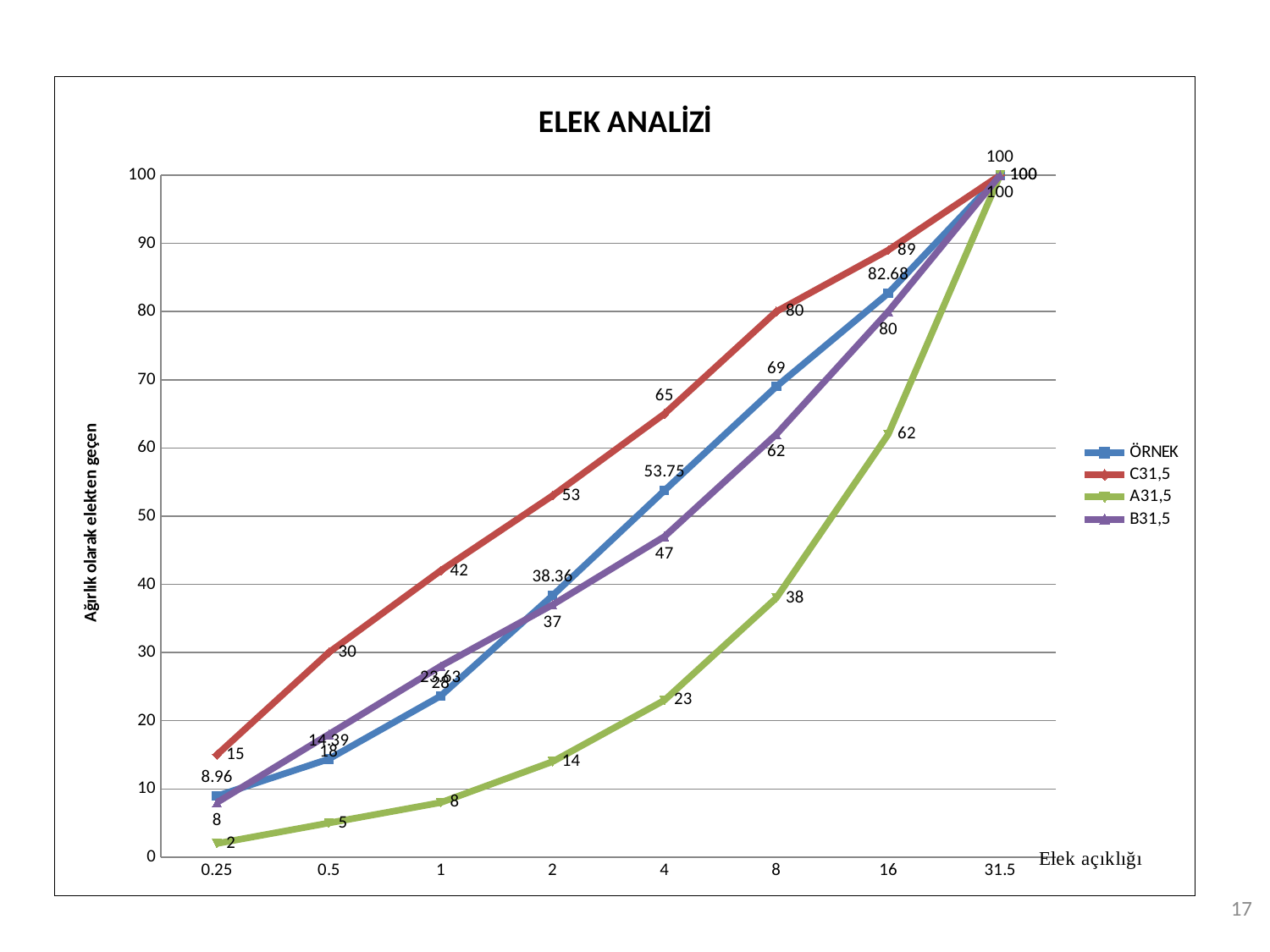
What is the difference between the C31,5 and A31,5 values at x = 16? 27 How many series does the legend list? 4 What is the value of the ÖRNEK series at x = 16? 82.68 What is the value of the C31,5 series at x = 4? 65 Which series has the lowest value at x = 0.25? A31,5 What is the value of the A31,5 series at x = 8? 38 Which series has the highest value at x = 2? C31,5 What type of chart is shown on the slide? line chart How many points are plotted along the x axis for each series? 8 Do the values of the A31,5 series rise or fall as the x axis increases? rise What is the title of the chart? ELEK ANALİZİ At x = 8, which is larger: the ÖRNEK value or the B31,5 value? ÖRNEK